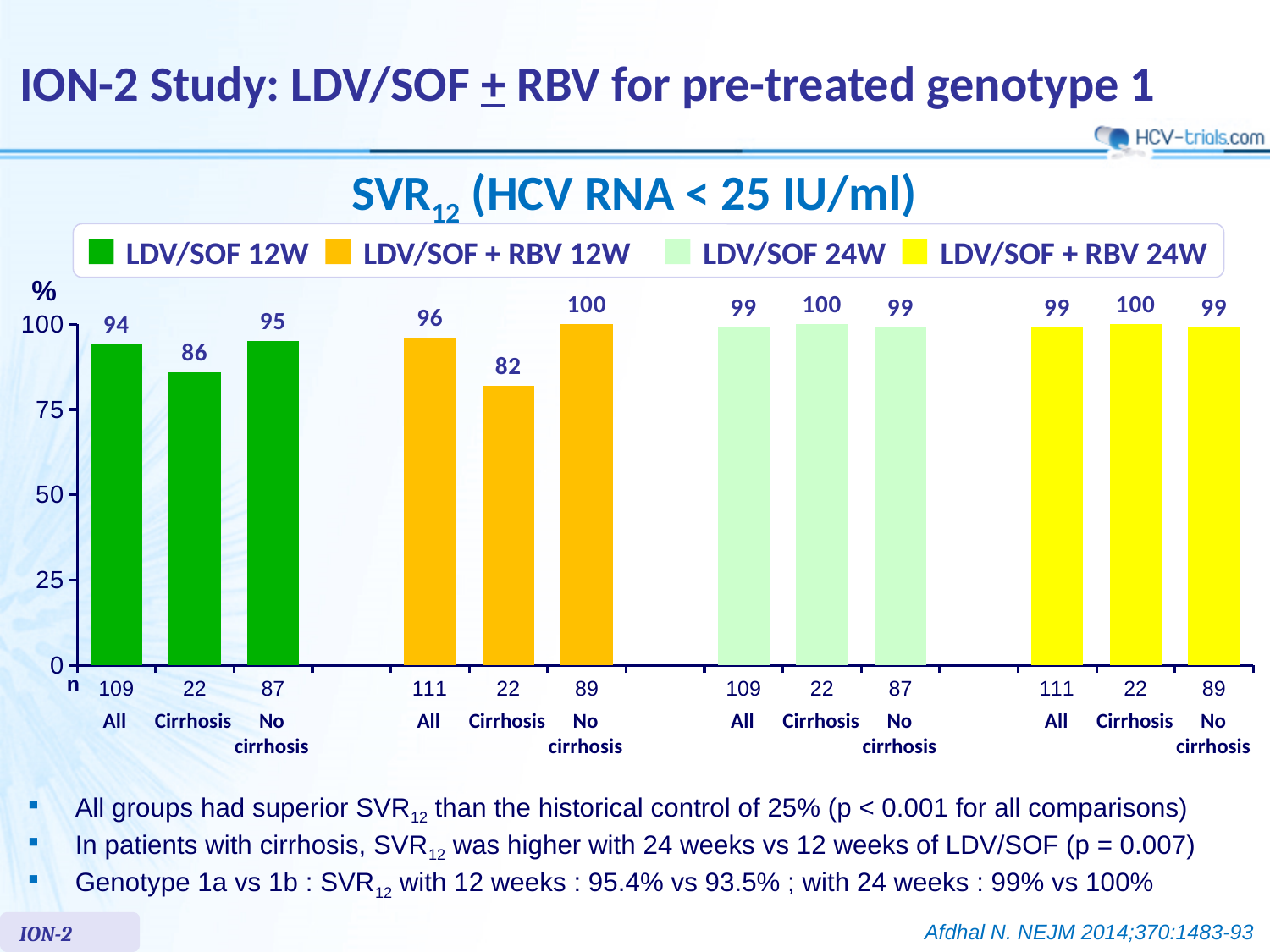
How many bars are plotted on the chart? 12 Is the Cirrhosis value for LDV/SOF + RBV 12W greater or less than 75? greater How many series does the legend list? 4 What is the n for the Cirrhosis group in the LDV/SOF + RBV 24W series? 22 What is the SVR12 value for the All group in the LDV/SOF 24W series? 99 Which is larger: the Cirrhosis value for LDV/SOF 12W or the Cirrhosis value for LDV/SOF 24W? LDV/SOF 24W What is the SVR12 value for the No cirrhosis group in the LDV/SOF + RBV 12W series? 100 What is the difference between the All and Cirrhosis SVR12 values in the LDV/SOF 12W series? 8 What is the SVR12 value for the Cirrhosis group in the LDV/SOF 12W series? 86 Which group has the lowest SVR12 value on the chart? Cirrhosis, LDV/SOF + RBV 12W What colour represents the LDV/SOF + RBV 12W series? Orange What kind of chart is shown? Bar chart